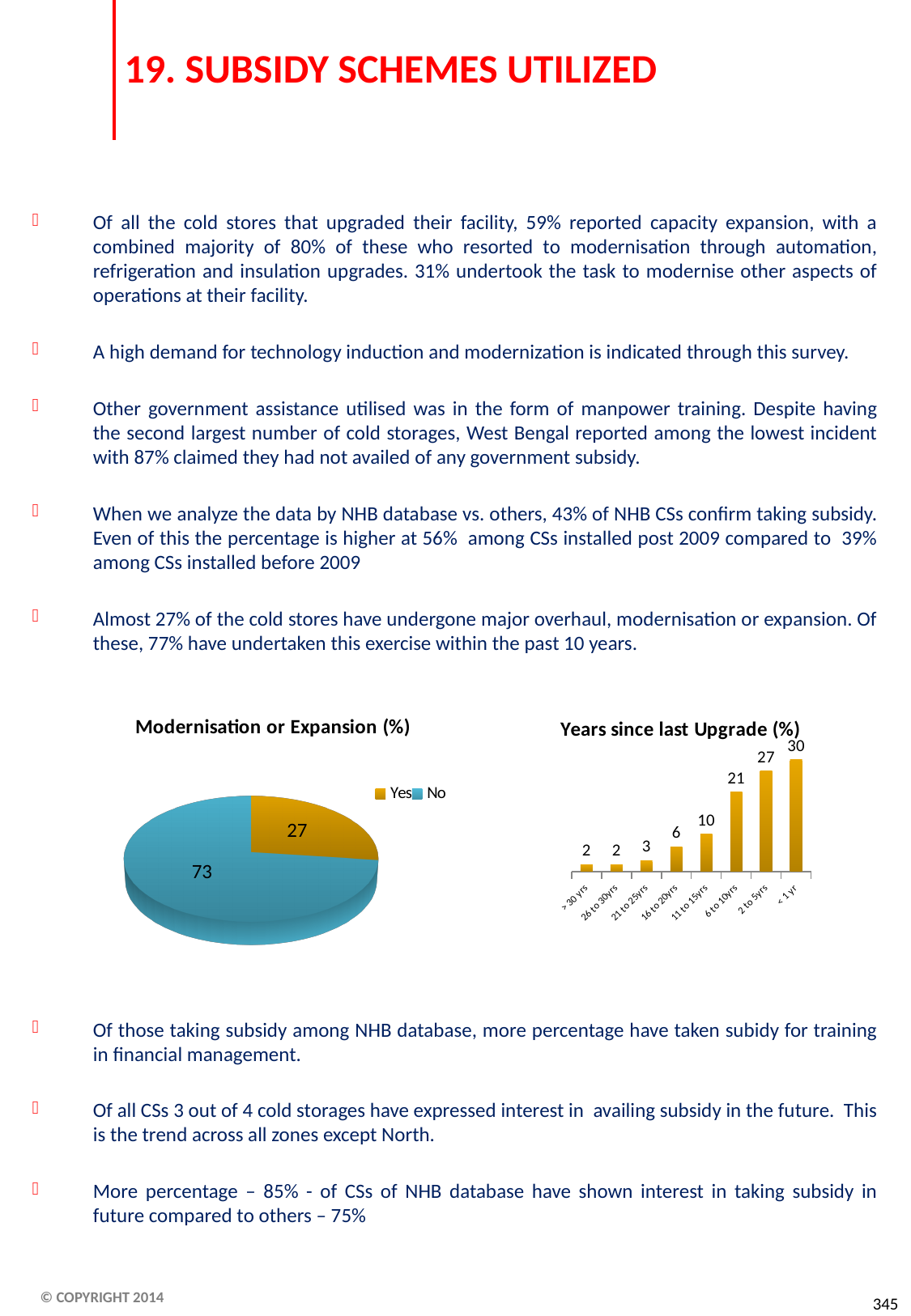
In the 'Modernisation or Expansion (%)' chart, what is the value for No? 73 How many series does the legend of the 'Modernisation or Expansion (%)' chart list? 2 In the 'Years since last Upgrade (%)' chart, which category has the highest value? < 1 yr What kind of chart is 'Years since last Upgrade (%)'? Bar chart How many categories are shown in the 'Years since last Upgrade (%)' chart? 8 What kind of chart is 'Modernisation or Expansion (%)'? Pie chart In the 'Years since last Upgrade (%)' chart, do the values rise or fall from left to right along the x axis? Rise In the 'Modernisation or Expansion (%)' chart, which slice is larger, Yes or No? No In the 'Modernisation or Expansion (%)' chart, what is the value for Yes? 27 In the 'Years since last Upgrade (%)' chart, what is the difference between the values for '2 to 5yrs' and '11 to 15yrs'? 17 In the 'Years since last Upgrade (%)' chart, what is the value for '6 to 10yrs'? 21 In the 'Years since last Upgrade (%)' chart, what is the value for '< 1 yr'? 30